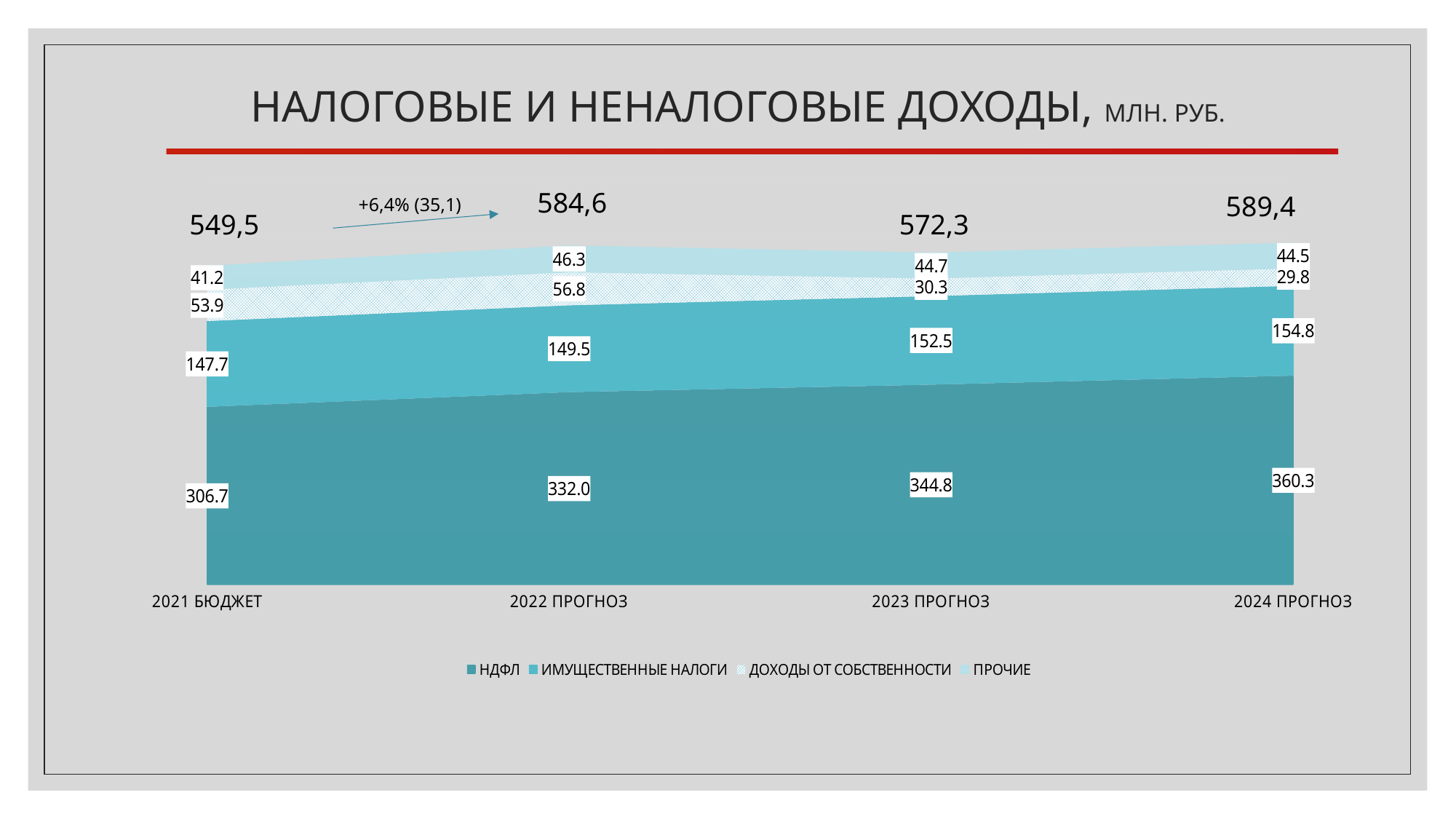
What is the difference between НДФЛ in 2024 ПРОГНОЗ and НДФЛ in 2021 БЮДЖЕТ? 53.6 What is the value of ИМУЩЕСТВЕННЫЕ НАЛОГИ for 2024 ПРОГНОЗ? 154.8 What type of chart is shown on the slide? Stacked area chart What is the value of НДФЛ for 2022 ПРОГНОЗ? 332.0 What is the value of ДОХОДЫ ОТ СОБСТВЕННОСТИ for 2021 БЮДЖЕТ? 53.9 In which category is ДОХОДЫ ОТ СОБСТВЕННОСТИ lowest? 2024 ПРОГНОЗ Which is larger: ПРОЧИЕ in 2022 ПРОГНОЗ or ПРОЧИЕ in 2021 БЮДЖЕТ? 2022 ПРОГНОЗ What is the total shown for 2023 ПРОГНОЗ? 572,3 How many series does the legend list? 4 How many categories are shown along the x axis? 4 What is the value of ПРОЧИЕ for 2023 ПРОГНОЗ? 44.7 In which category is НДФЛ highest? 2024 ПРОГНОЗ